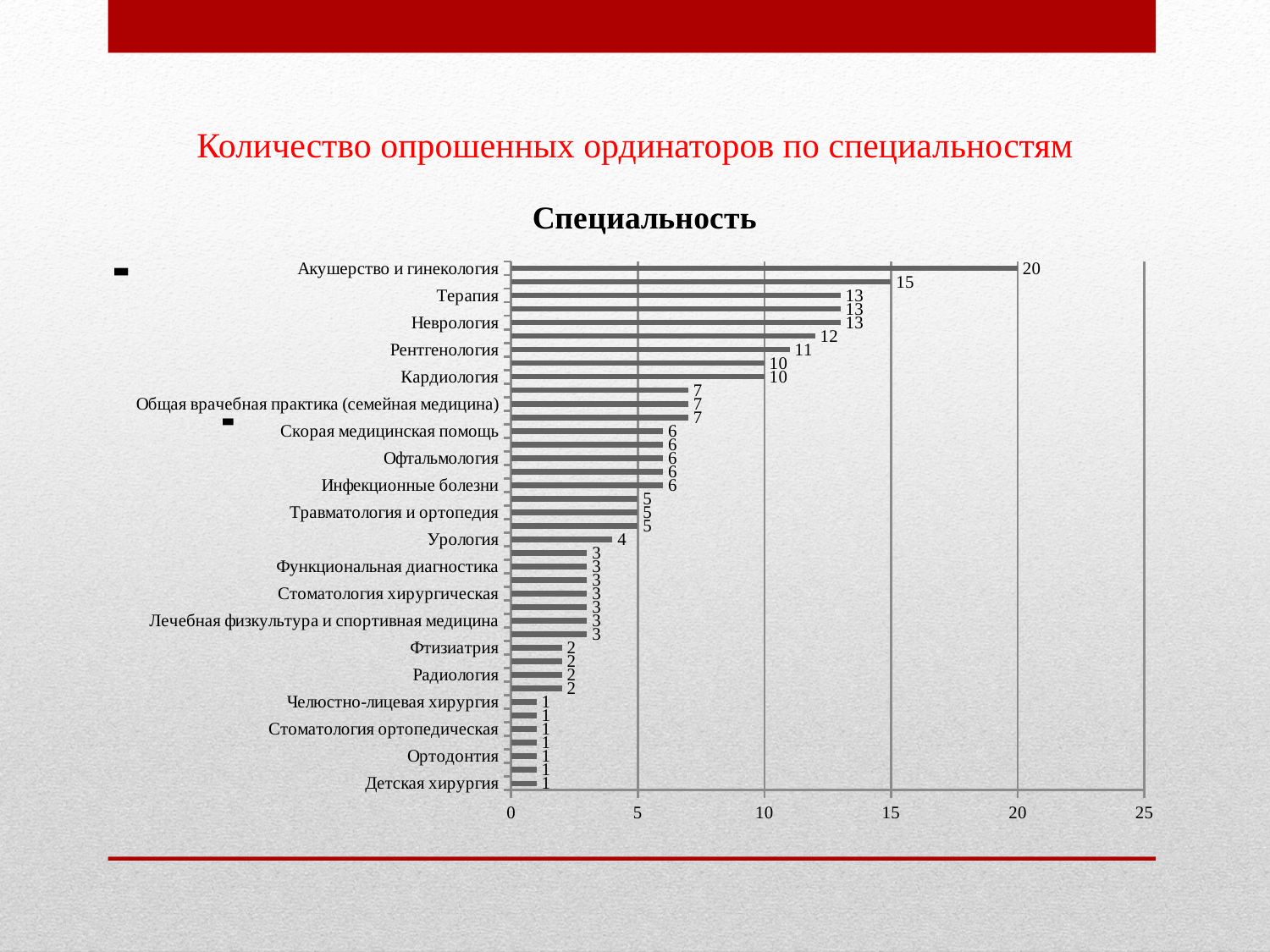
What type of chart is shown on the slide? bar chart Is the value for Акушерство и гинекология greater or less than 15? greater What is the value for Фтизиатрия? 2 What is the title of the chart? Специальность What is the value for Акушерство и гинекология? 20 Which has a larger value, Рентгенология or Кардиология? Рентгенология What is the difference between the values for Акушерство и гинекология and Терапия? 7 What is the value for Терапия? 13 What is the value for Рентгенология? 11 What is the difference between the values for Кардиология and Урология? 6 Which specialty has the highest value? Акушерство и гинекология What is the value for Урология? 4